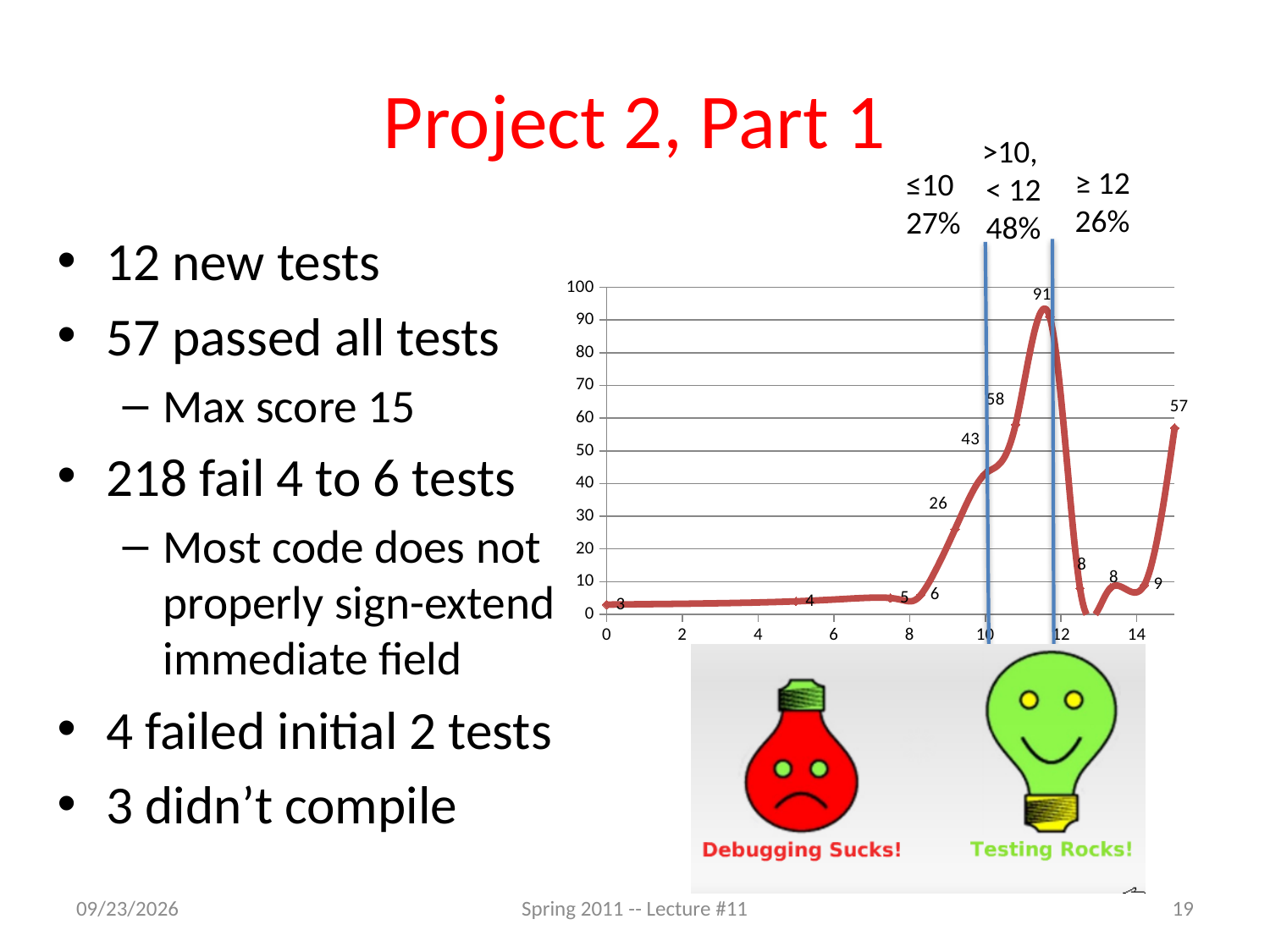
Which is larger, the value labeled 58 or the value labeled 43? 58 What percentage is shown above the chart for scores ≤10? 27% What is the difference between the peak value 91 and the value 58 labeled just before it? 33 What is the difference between the value 57 at the right end and the value 43 labeled near score 10? 14 What kind of chart is shown on the slide? line chart How many data labels are printed on the line? 12 What is the highest value labeled on the chart? 91 What is the value labeled at the rightmost end of the line (score 15)? 57 Do the values generally rise or fall along the x axis from score 0 up to the peak near score 12? rise What is the value labeled at the leftmost point of the line (score 0)? 3 What percentage is shown above the chart for scores >10 and <12? 48% What is the lowest value labeled on the chart? 3